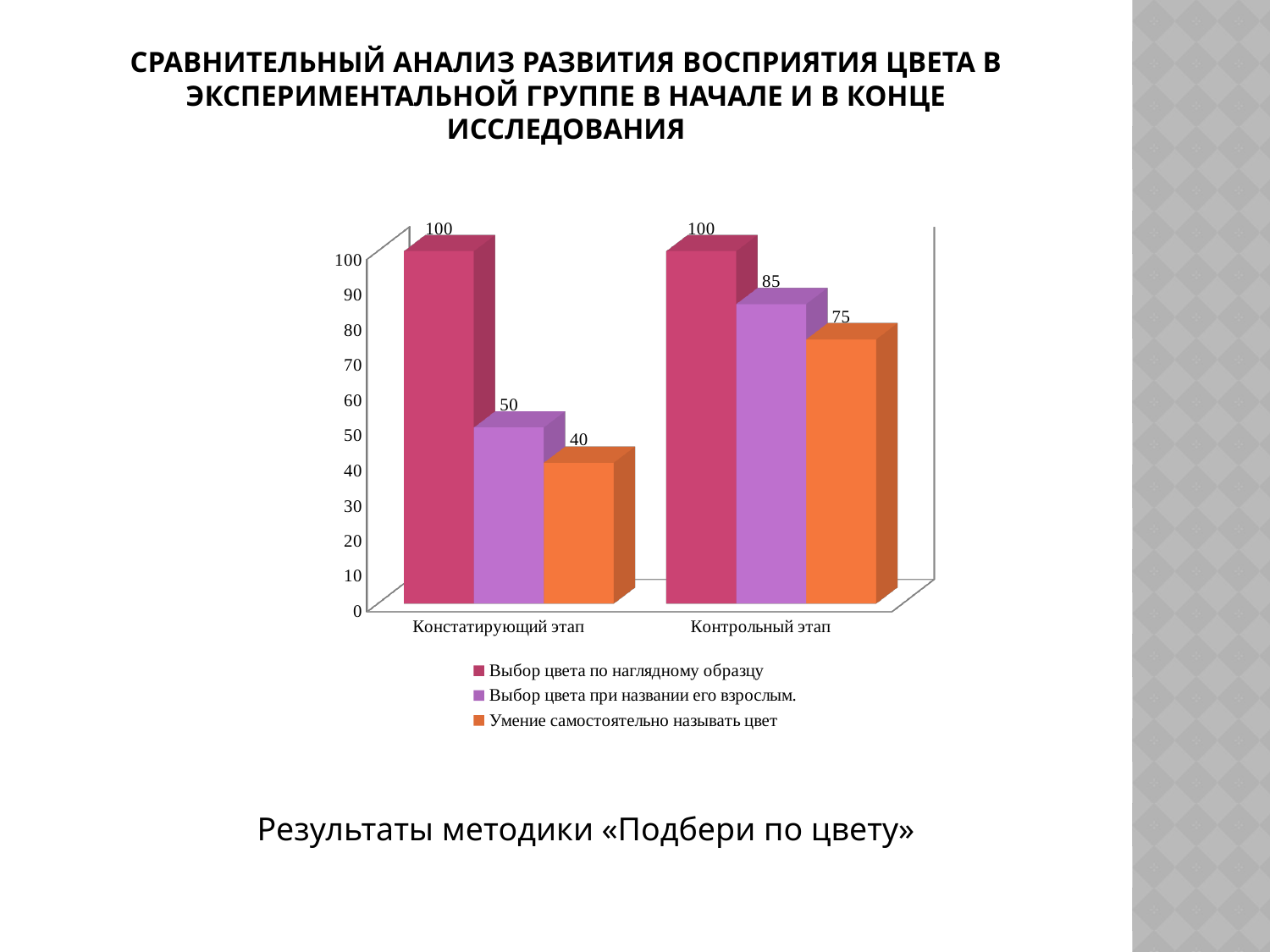
How many series does the legend list? 3 Which series has the lowest value at the Констатирующий этап? Умение самостоятельно называть цвет What is the value for «Умение самостоятельно называть цвет» at the Констатирующий этап? 40 What is the difference between the Контрольный этап and Констатирующий этап values for «Выбор цвета при названии его взрослым.»? 35 What is the value for «Умение самостоятельно называть цвет» at the Контрольный этап? 75 What is the value for «Выбор цвета при названии его взрослым.» at the Констатирующий этап? 50 Which is larger: «Выбор цвета при названии его взрослым.» at the Контрольный этап or «Умение самостоятельно называть цвет» at the Контрольный этап? Выбор цвета при названии его взрослым. What is the difference between the Контрольный этап and Констатирующий этап values for «Умение самостоятельно называть цвет»? 35 Does the value for «Умение самостоятельно называть цвет» rise or fall from the Констатирующий этап to the Контрольный этап? Rise What kind of chart is shown on the slide? Bar chart How many categories are shown on the x axis? 2 What is the value for «Выбор цвета по наглядному образцу» at the Контрольный этап? 100